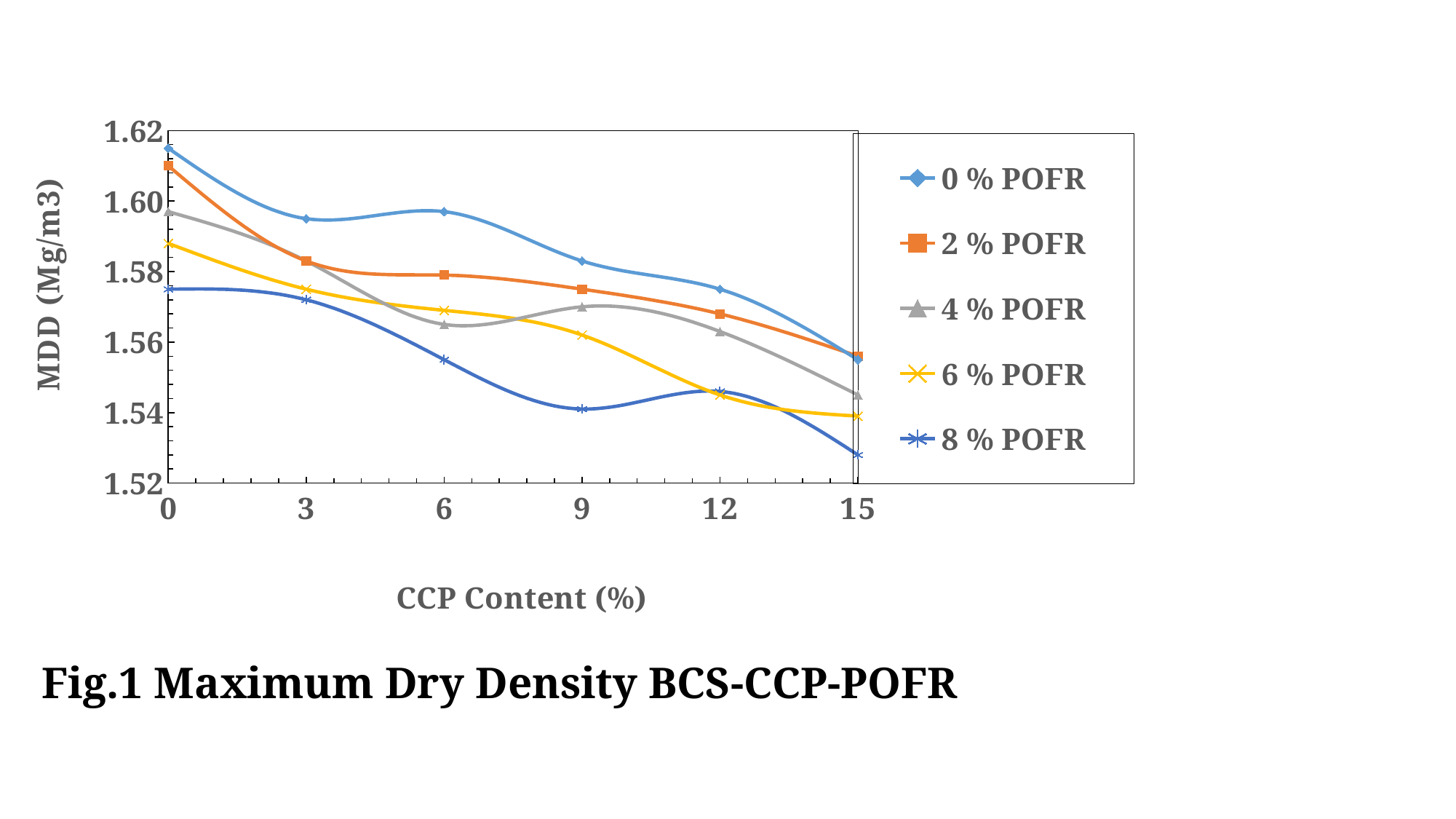
What is the label of the y axis? MDD (Mg/m3) Which series has the lowest MDD at 15% CCP content? 8 % POFR What kind of chart is shown on the slide? Line chart Is the MDD for 8 % POFR at 15% CCP content greater or less than 1.54? less Overall, does the MDD for 0 % POFR rise or fall as CCP content increases from 0 to 15%? Fall How many CCP content values are plotted along the x axis for each series? 6 At 12% CCP content, which series has the larger MDD: 2 % POFR or 6 % POFR? 2 % POFR Which series has the highest MDD at 0% CCP content? 0 % POFR Which series has the lowest MDD at 6% CCP content? 8 % POFR How many series does the legend list? 5 At 9% CCP content, which series has the larger MDD: 0 % POFR or 8 % POFR? 0 % POFR Is the MDD for 0 % POFR at 0% CCP content greater or less than 1.60? greater